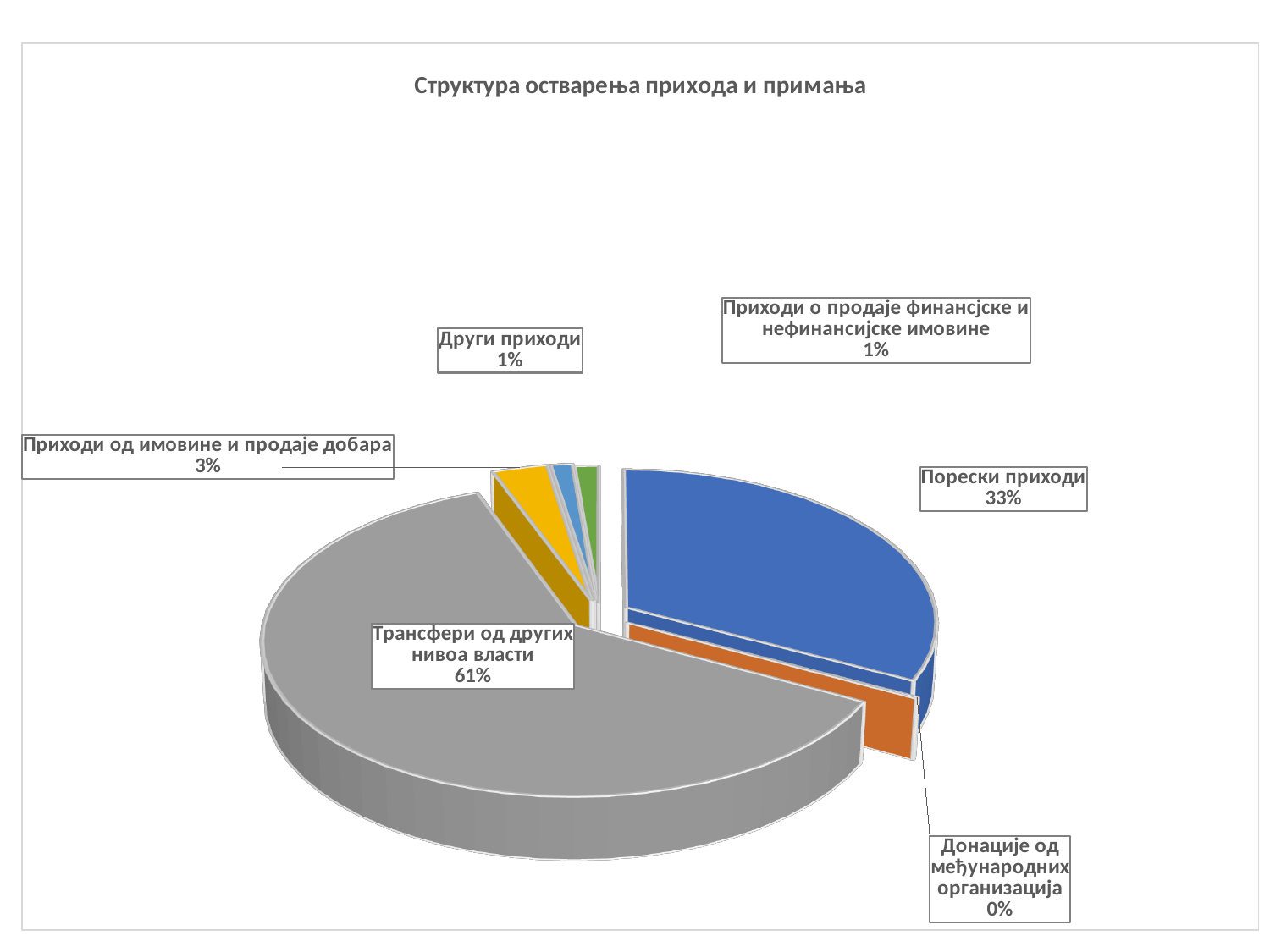
Which category has the largest share of the pie? Трансфери од других нивоа власти What percentage is shown for Приходи од имовине и продаје добара? 3% What is the title of the chart? Структура остварења прихода и примања Which is larger: Порески приходи or Приходи од имовине и продаје добара? Порески приходи What percentage is shown for Донације од међународних организација? 0% What share of the pie is Трансфери од других нивоа власти? 61% What percentage is shown for Други приходи? 1% What kind of chart is shown on the slide? Pie chart What share of the pie is Порески приходи? 33% How many categories are shown in the pie chart? 6 What is the difference in percentage points between Трансфери од других нивоа власти and Порески приходи? 28 percentage points Which category has the smallest share of the pie? Донације од међународних организација